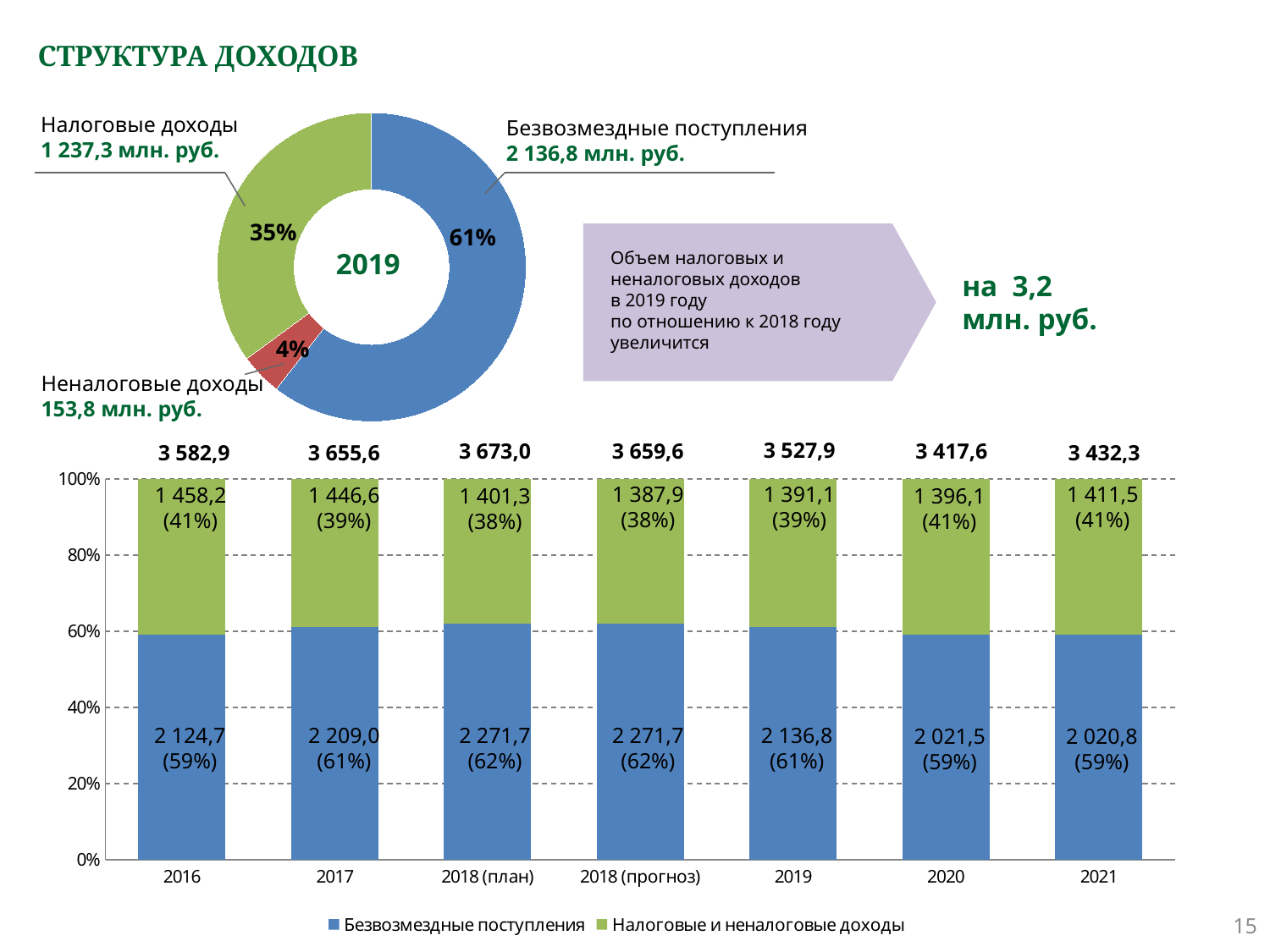
In the stacked bar chart, what is the difference between Налоговые и неналоговые доходы in 2016 and in 2021? 46,7 In the stacked bar chart, what is the value of Безвозмездные поступления for 2019? 2 136,8 What kind of chart is the chart at the top of the slide? Pie (donut) chart In the donut chart, what share of 2019 income is Безвозмездные поступления? 61% How many series does the legend of the stacked bar chart list? 2 In the stacked bar chart, which year has the highest total? 2018 (план) How many categories (years) are shown on the x axis of the stacked bar chart? 7 In the stacked bar chart, which year has the lowest total? 2020 In the donut chart, which category has the smallest slice? Неналоговые доходы In the donut chart, what is the value of Налоговые доходы? 1 237,3 млн. руб. In the stacked bar chart, what is the total for 2018 (план)? 3 673,0 In the stacked bar chart, which is larger: Безвозмездные поступления in 2017 or in 2020? 2017